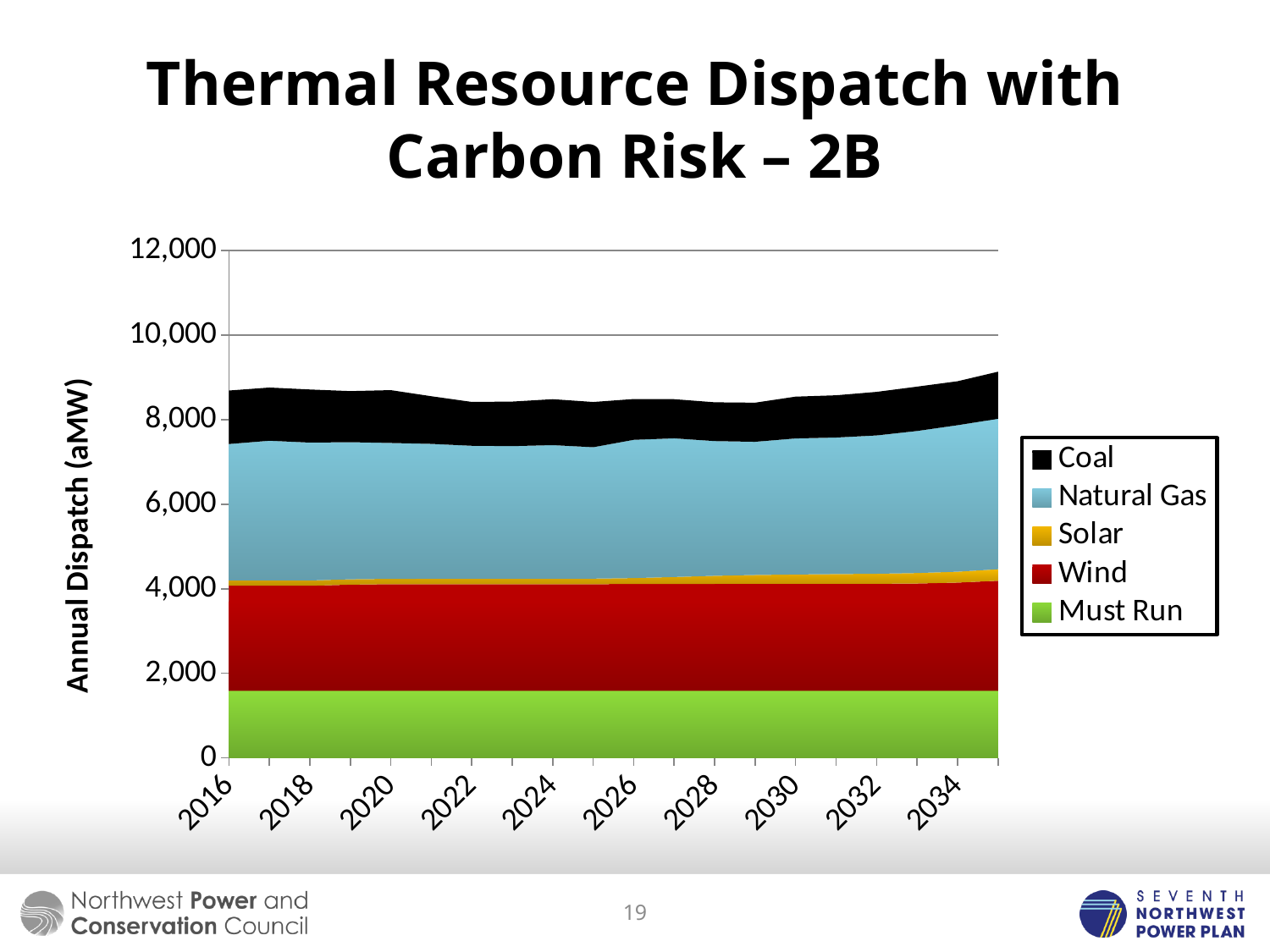
What kind of chart is shown on the slide? stacked area chart Which series occupies the largest band in the stacked area? Natural Gas Is the total stacked value in 2034 greater or less than 8,000? greater How many year labels are shown on the x axis? 10 Is the total stacked value in 2016 greater or less than 10,000? less Which series occupies the smallest band in the stacked area? Solar What is the label on the vertical axis? Annual Dispatch (aMW) Which series is shown in black in the legend? Coal How many series does the legend list? 5 Does the total stacked value rise or fall between 2030 and the end of the series? rise What is the title of the chart? Thermal Resource Dispatch with Carbon Risk – 2B Is the Must Run value in 2016 greater or less than 2,000? less